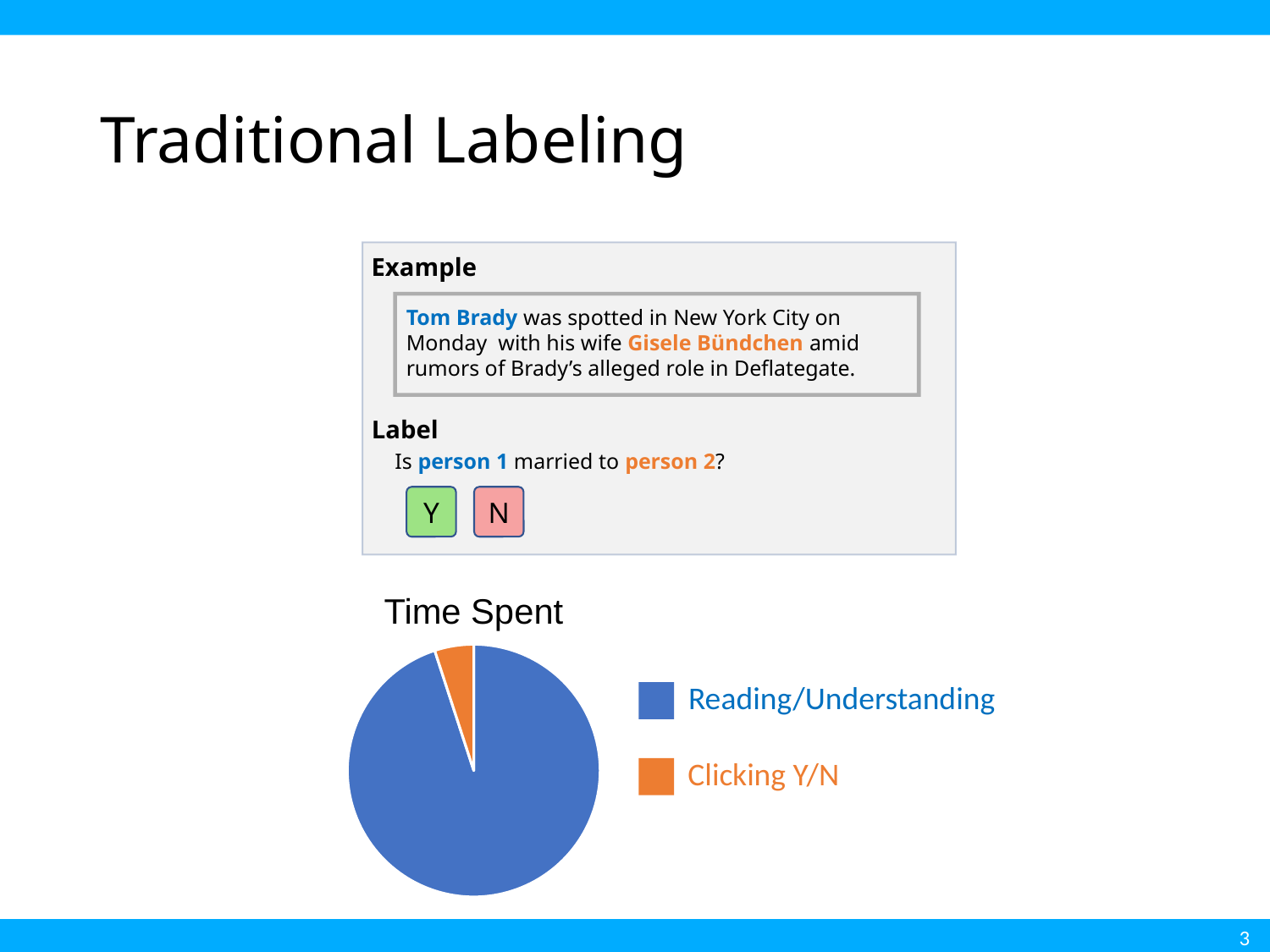
Which legend entry in the Time Spent pie chart is shown in blue? Reading/Understanding How many slices does the Time Spent pie chart have? 2 What colour is the Clicking Y/N slice in the Time Spent pie chart? orange Which slice of the Time Spent pie chart is the largest? Reading/Understanding How many entries does the legend of the Time Spent pie chart list? 2 What kind of chart is shown under the heading "Time Spent"? pie chart What is the title of the pie chart? Time Spent Which slice of the Time Spent pie chart is the smallest? Clicking Y/N In the Time Spent pie chart, which is larger: Reading/Understanding or Clicking Y/N? Reading/Understanding